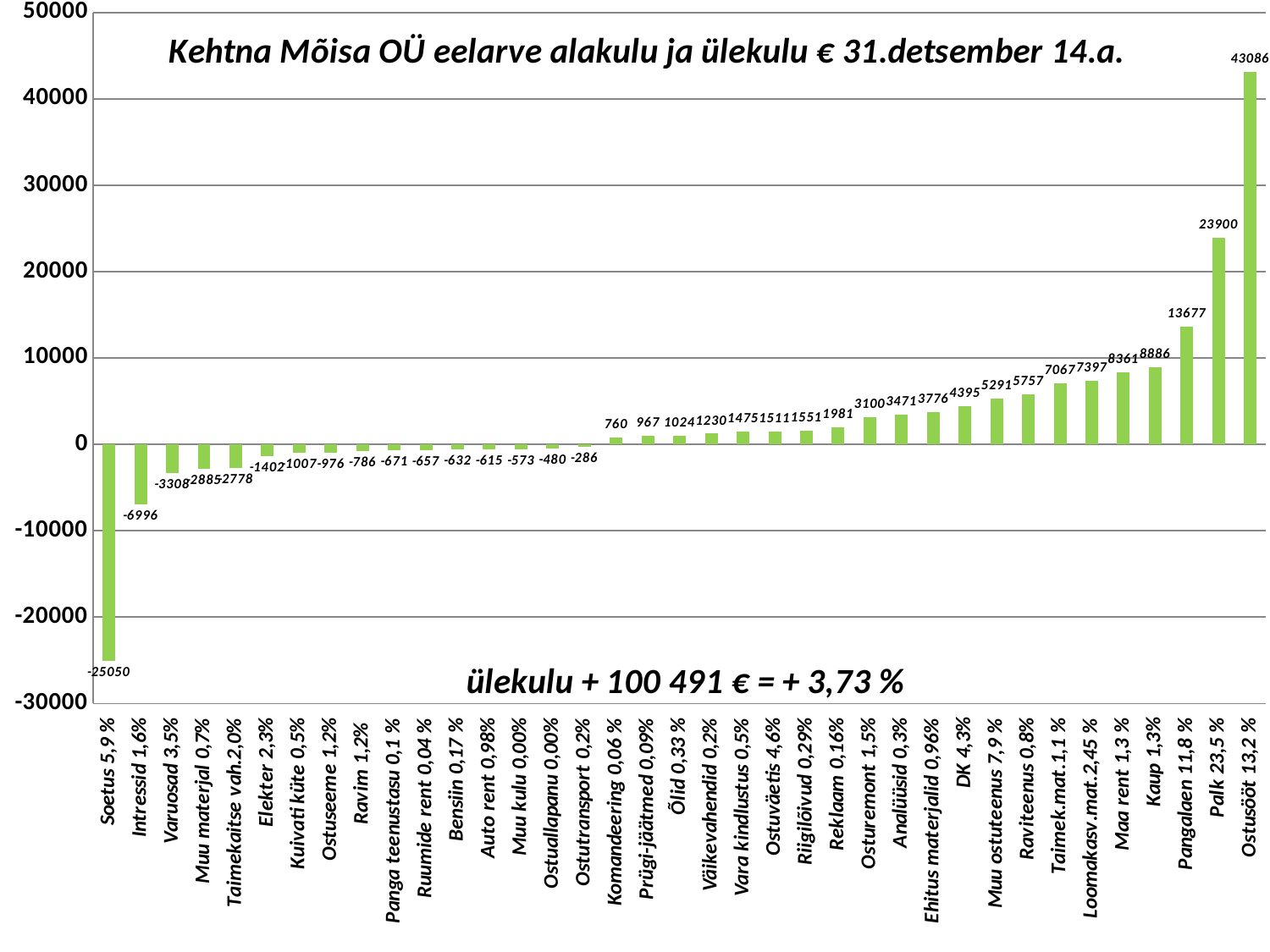
Which category has the lowest value? Soetus 5,9 % What is the value for Pangalaen 11,8 %? 13677 What is the title of the chart? Kehtna Mõisa OÜ eelarve alakulu ja ülekulu € 31.detsember 14.a. Which is larger, the value for Kaup 1,3% or the value for Maa rent 1,3 %? Kaup 1,3% What is the value for Palk 23,5 %? 23900 What is the value for Soetus 5,9 %? -25050 What kind of chart is shown on the slide? bar chart Which category has the highest value? Ostusööt 13,2 % What is the value for Ostusööt 13,2 %? 43086 How many categories are shown on the x axis? 37 What is the difference between the values for Ostusööt 13,2 % and Palk 23,5 %? 19186 Is the value for Palk 23,5 % greater or less than 20000? greater